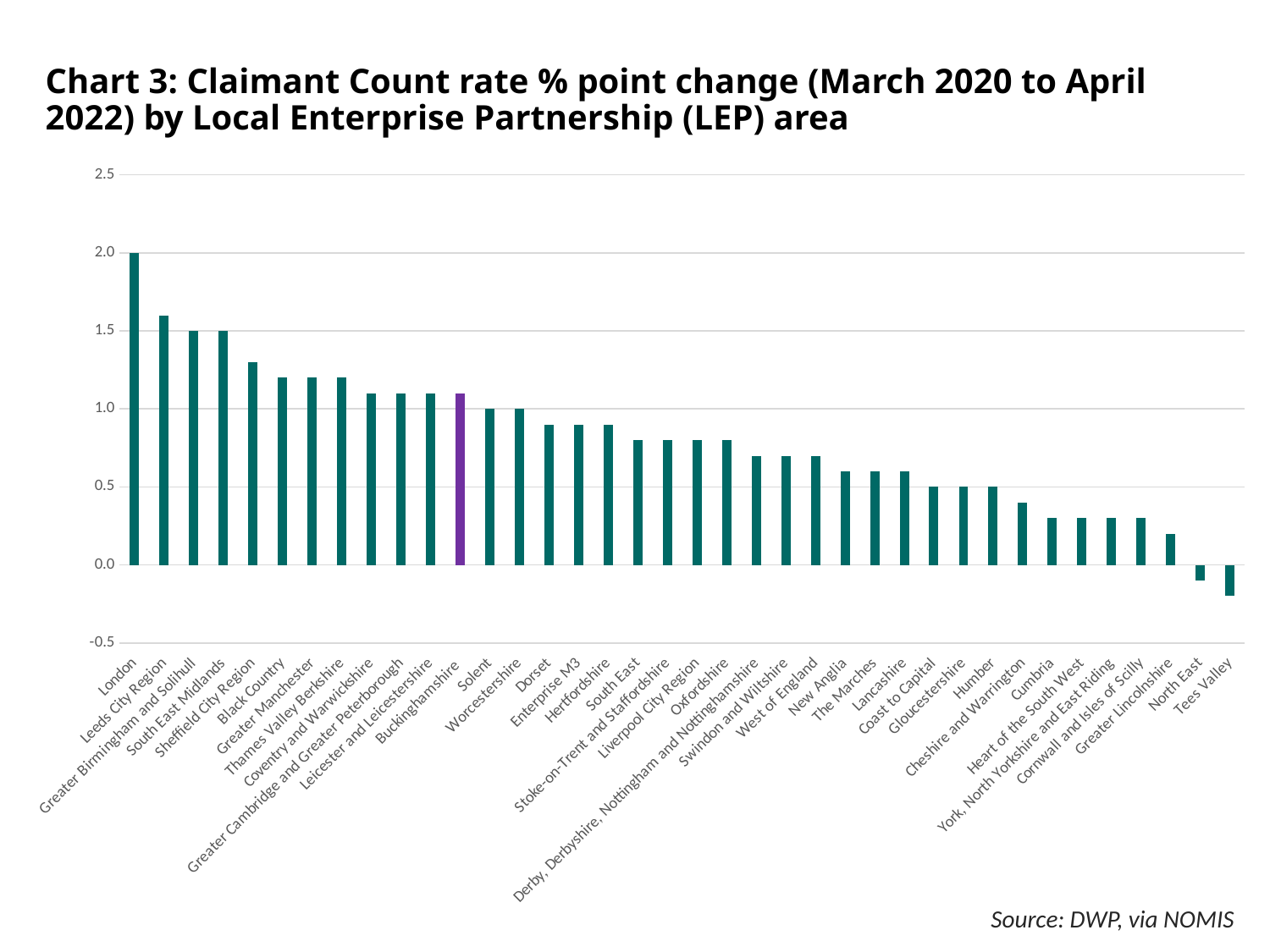
What is the Claimant Count rate % point change for London? 2.0 What kind of chart is shown on the slide? Bar chart Which has a larger Claimant Count rate % point change, London or Leeds City Region? London How many LEP areas are shown on the chart? 38 Is the value for Sheffield City Region greater or less than 1.0? greater Is the value for Leeds City Region greater or less than 1.5? greater Is the value for Cumbria greater or less than 0.5? less What is the Claimant Count rate % point change for Solent? 1.0 Which LEP area has the lowest Claimant Count rate % point change? Tees Valley Which LEP area has the highest Claimant Count rate % point change? London Which LEP area's bar is highlighted in purple? Buckinghamshire What is the Claimant Count rate % point change for Humber? 0.5